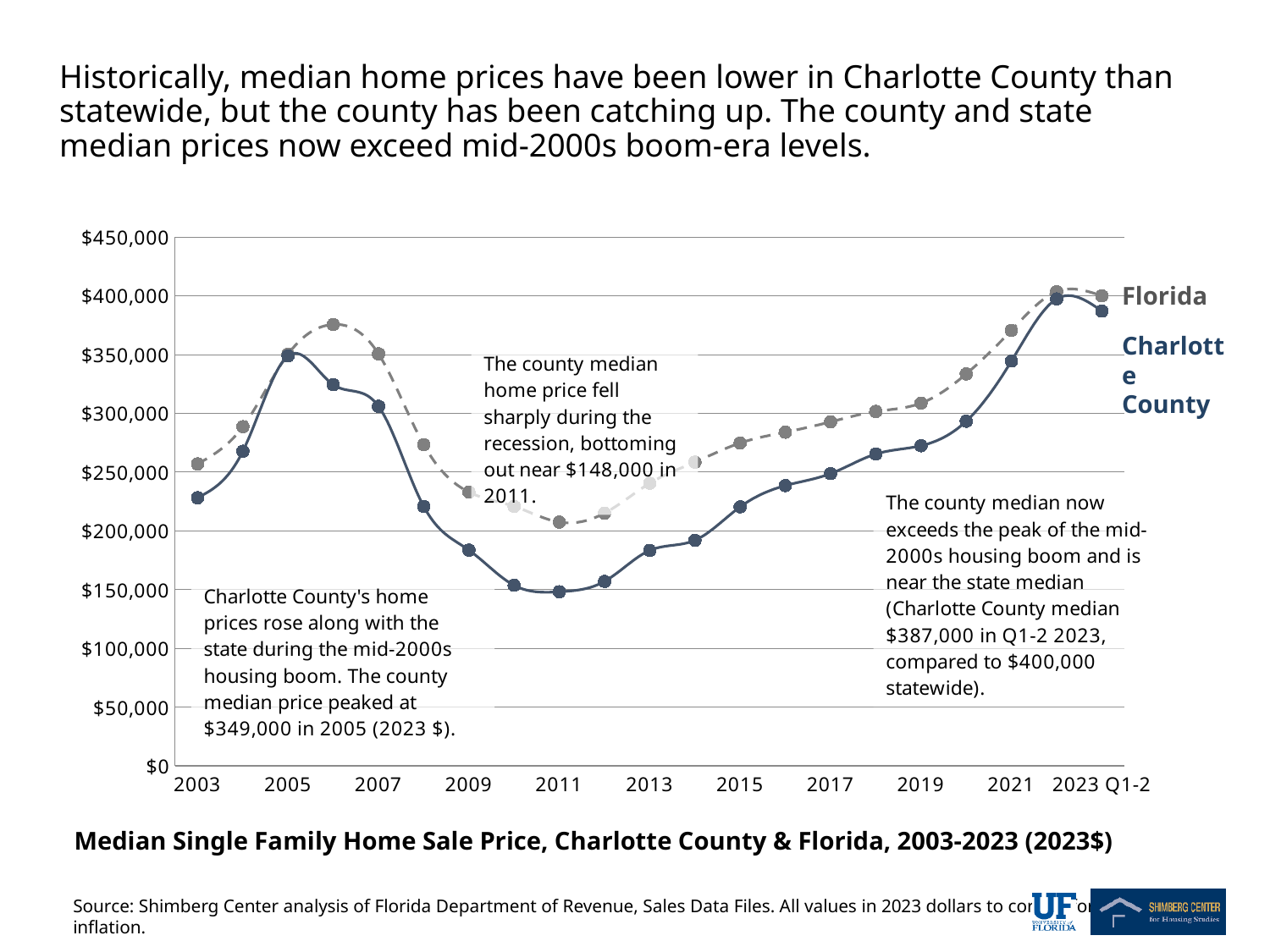
Is the Charlotte County value for 2003 greater or less than $250,000? less Does the Charlotte County line rise or fall between 2011 and 2023 Q1-2? rise What was the Charlotte County median home price at its 2005 peak, according to the chart annotation? $349,000 What is the Florida statewide median home price in Q1-2 2023, according to the chart annotation? $400,000 In which year does the Charlotte County line reach its lowest point? 2011 What kind of chart is shown on the slide? Line chart Is the Florida value for 2006 greater or less than $350,000? greater How much higher is the Florida median than the Charlotte County median in Q1-2 2023? $13,000 Which series has the higher value in 2003, Florida or Charlotte County? Florida Which two series are plotted on the chart? Florida and Charlotte County How many series does the chart show? 2 What is the Charlotte County median home price in Q1-2 2023, according to the chart annotation? $387,000